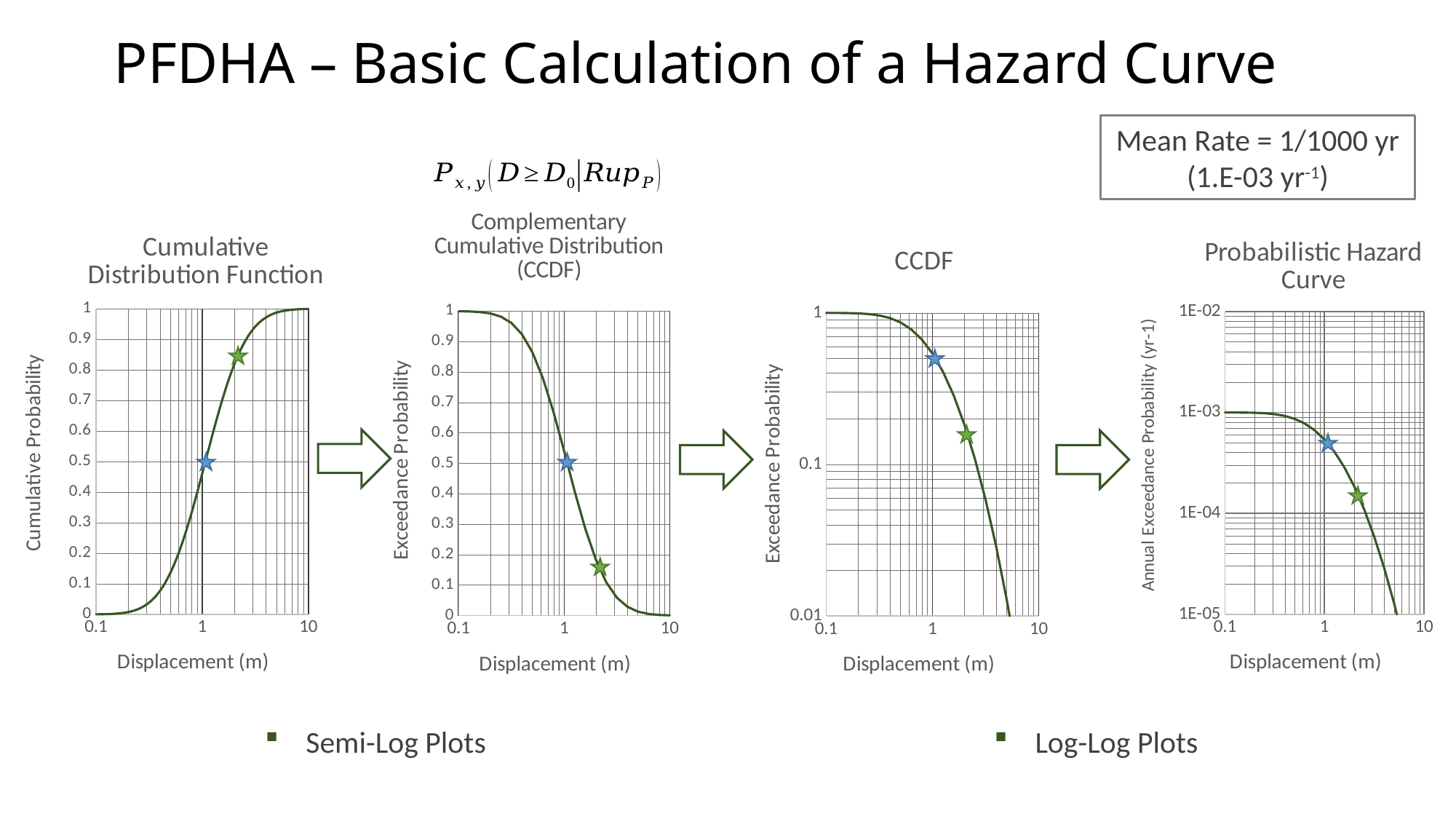
What kind of chart is the Cumulative Distribution Function chart? line chart In the Cumulative Distribution Function chart, is the value at a displacement of 0.1 m greater or less than 0.1? less In the Cumulative Distribution Function chart, is the value at a displacement of 10 m greater or less than 0.9? greater In the Probabilistic Hazard Curve chart, is the value at a displacement of 1 m greater or less than 1E-03? less In the Complementary Cumulative Distribution (CCDF) chart, do the values rise or fall as displacement increases? fall In the Probabilistic Hazard Curve chart, do the values rise or fall as displacement increases? fall In the Cumulative Distribution Function chart, do the values rise or fall as displacement increases? rise What is the y-axis title of the Probabilistic Hazard Curve chart? Annual Exceedance Probability (yr-1) What is the x-axis title of the Cumulative Distribution Function chart? Displacement (m) In the Probabilistic Hazard Curve chart, which displacement has the larger value, 0.1 m or 10 m? 0.1 m